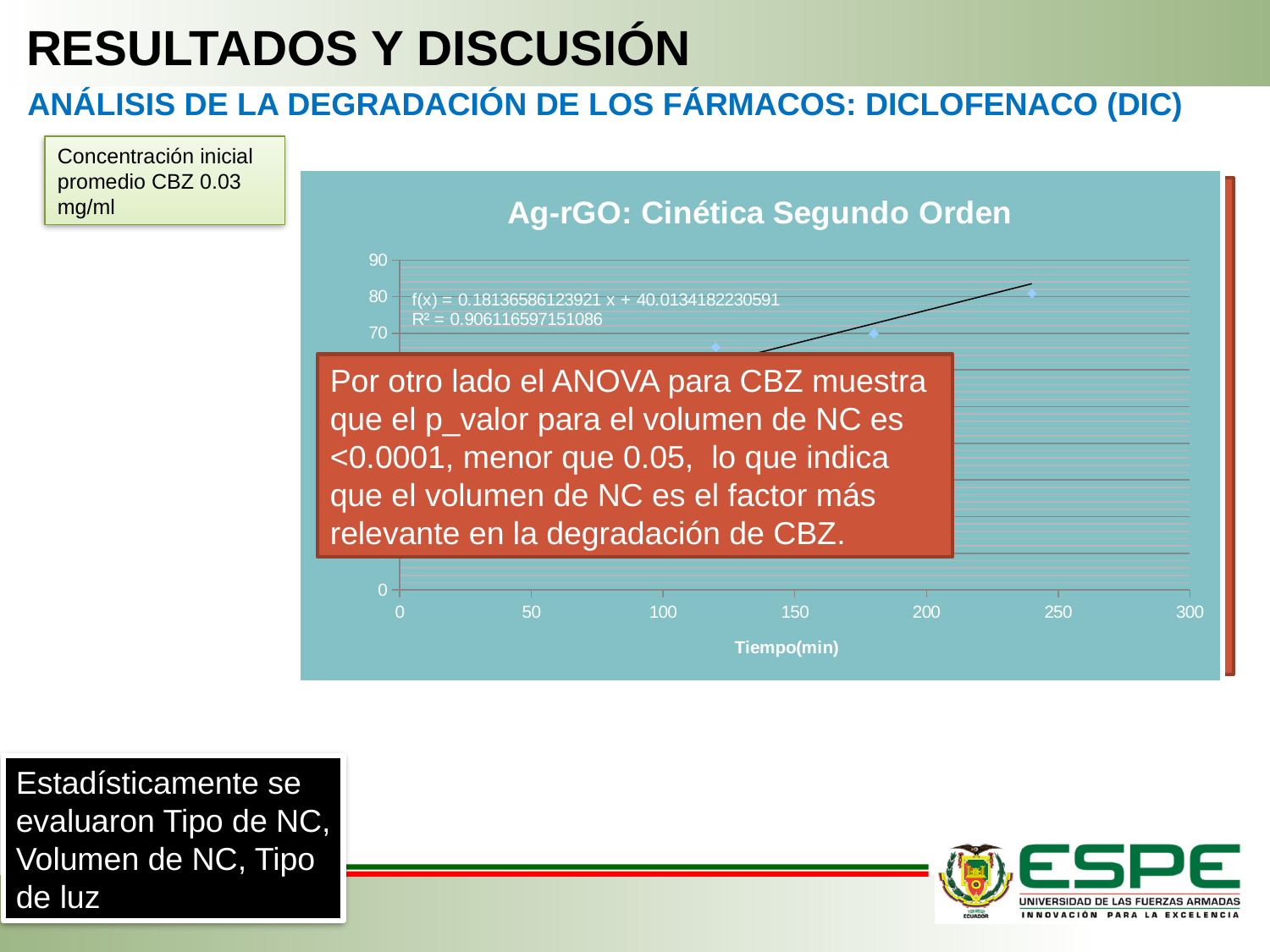
Do the plotted values rise or fall as time increases along the x axis? rise What is the slope of the trendline shown on the chart? 0.18136586123921 What kind of chart is shown on the slide? scatter chart with a trendline What is the label of the x axis of the chart? Tiempo(min) What is the highest tick value shown on the x axis? 300 What is the intercept of the trendline shown on the chart? 40.0134182230591 What is the trendline equation printed on the chart? f(x) = 0.18136586123921 x + 40.0134182230591 What is the title of the chart? Ag-rGO: Cinética Segundo Orden What R² value is printed on the chart? R² = 0.906116597151086 Is the value of the data point at 240 min greater or less than 70? greater What is the highest tick value shown on the y axis? 90